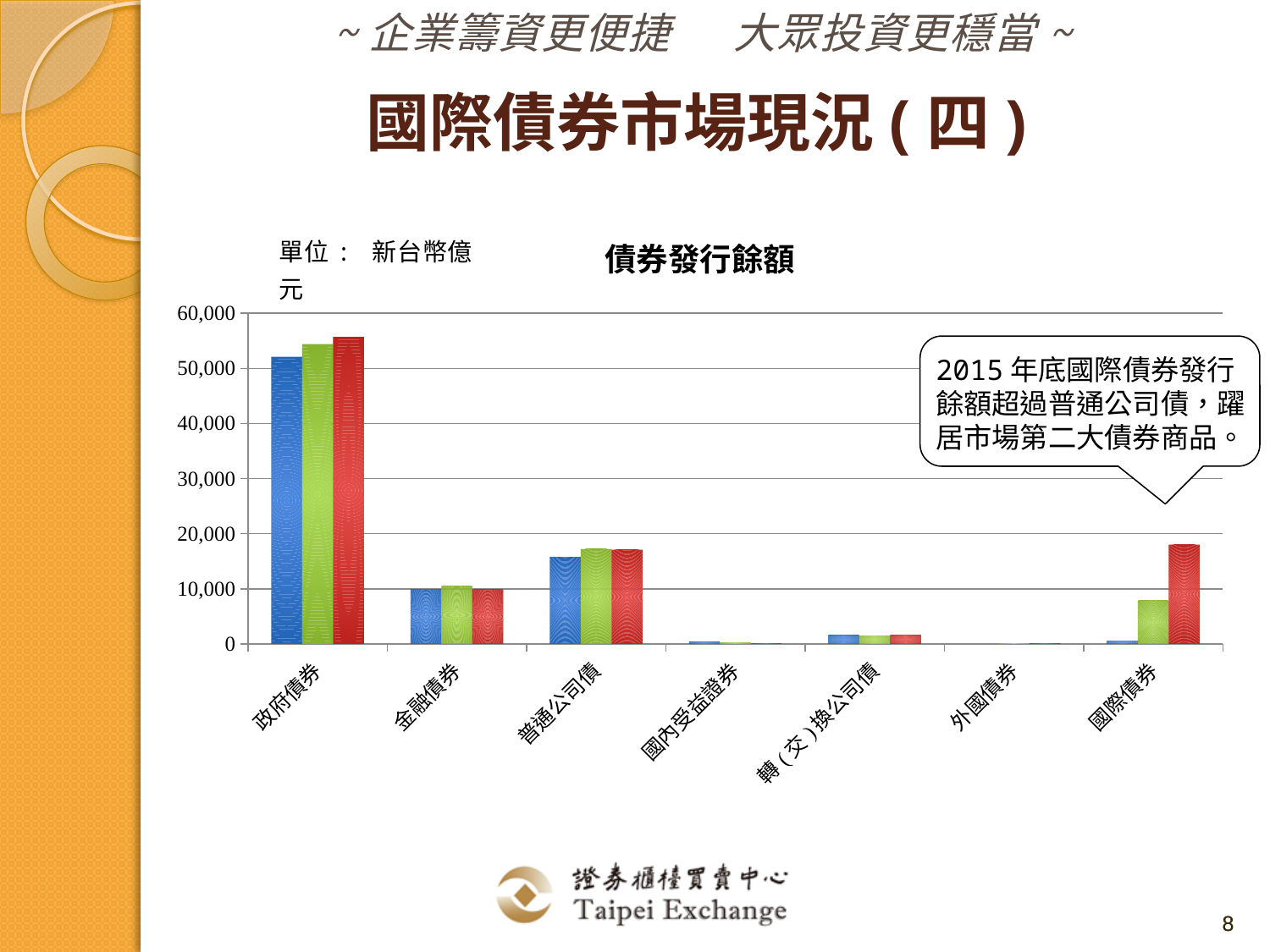
Is the value of the blue bar for 普通公司債 greater or less than 20,000? less What kind of chart is shown on the slide? bar chart What unit is stated for the values in the chart? 新台幣億元 Is the value of the red bar for 國際債券 greater or less than 10,000? greater Which category has the highest bars in the chart? 政府債券 Is the value of the green bar for 金融債券 greater or less than 20,000? less Which is larger, the blue bar for 政府債券 or the blue bar for 金融債券? 政府債券 What is the title of the chart? 債券發行餘額 Which is larger, the red bar for 國際債券 or the red bar for 普通公司債? 國際債券 Do the bars for 國際債券 rise or fall from the blue bar to the red bar? rise How many categories are shown on the x axis of the chart? 7